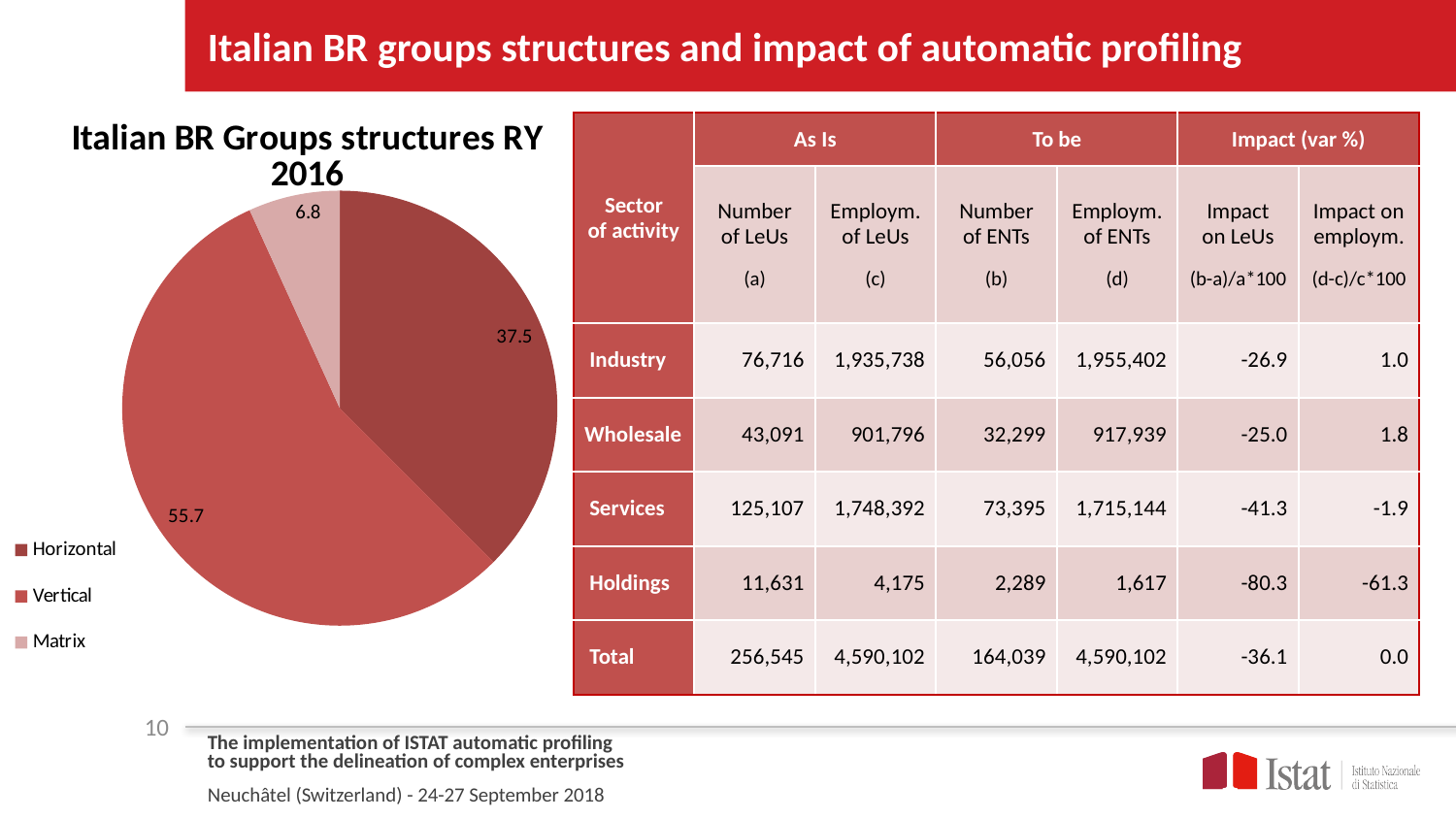
What kind of chart is shown on the slide? pie chart What is the value for Matrix in the pie chart? 6.8 What is the difference between the Vertical and Horizontal values in the pie chart? 18.2 What is the value for Horizontal in the pie chart? 37.5 How many slices does the pie chart have? 3 Which category has the smallest slice in the pie chart? Matrix How many entries does the pie chart legend list? 3 Which category has the largest slice in the pie chart? Vertical What is the difference between the Horizontal and Matrix values in the pie chart? 30.7 Which is larger in the pie chart, Horizontal or Matrix? Horizontal What is the title of the pie chart? Italian BR Groups structures RY 2016 What is the value for Vertical in the pie chart? 55.7